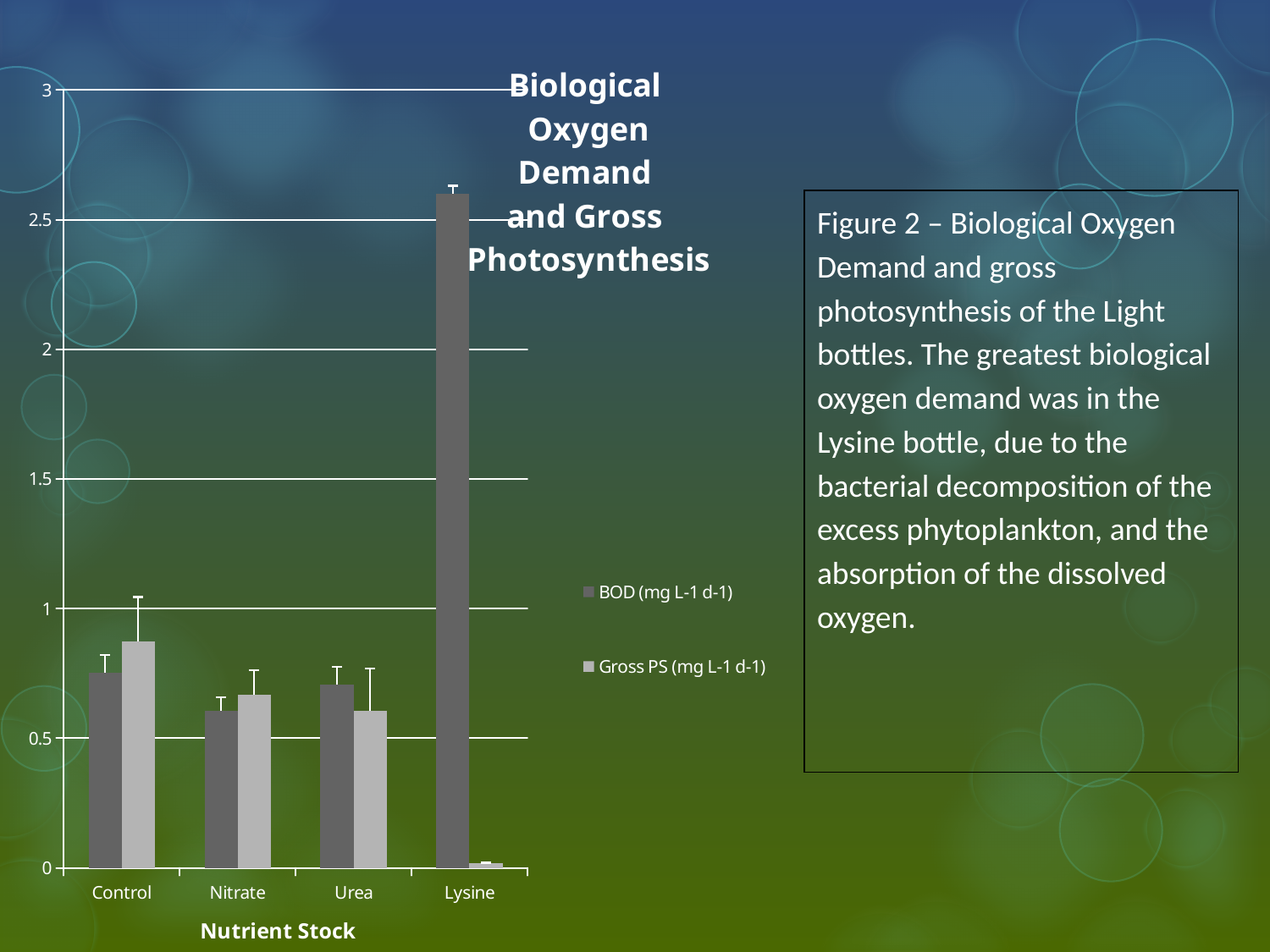
Is the Gross PS (mg L-1 d-1) value for Lysine greater or less than 0.5? less What kind of chart is shown on the slide? bar chart What is the title of the x axis? Nutrient Stock Which nutrient stock has the highest BOD (mg L-1 d-1) value? Lysine How many nutrient stock categories are shown on the x axis? 4 Which is larger, the BOD (mg L-1 d-1) value for Lysine or for Control? Lysine Is the BOD (mg L-1 d-1) value for Lysine greater or less than 2.5? greater Which nutrient stock has the lowest Gross PS (mg L-1 d-1) value? Lysine Is the BOD (mg L-1 d-1) value for Control greater or less than 0.5? greater Which is larger, the Gross PS (mg L-1 d-1) value for Control or for Nitrate? Control How many series does the legend list? 2